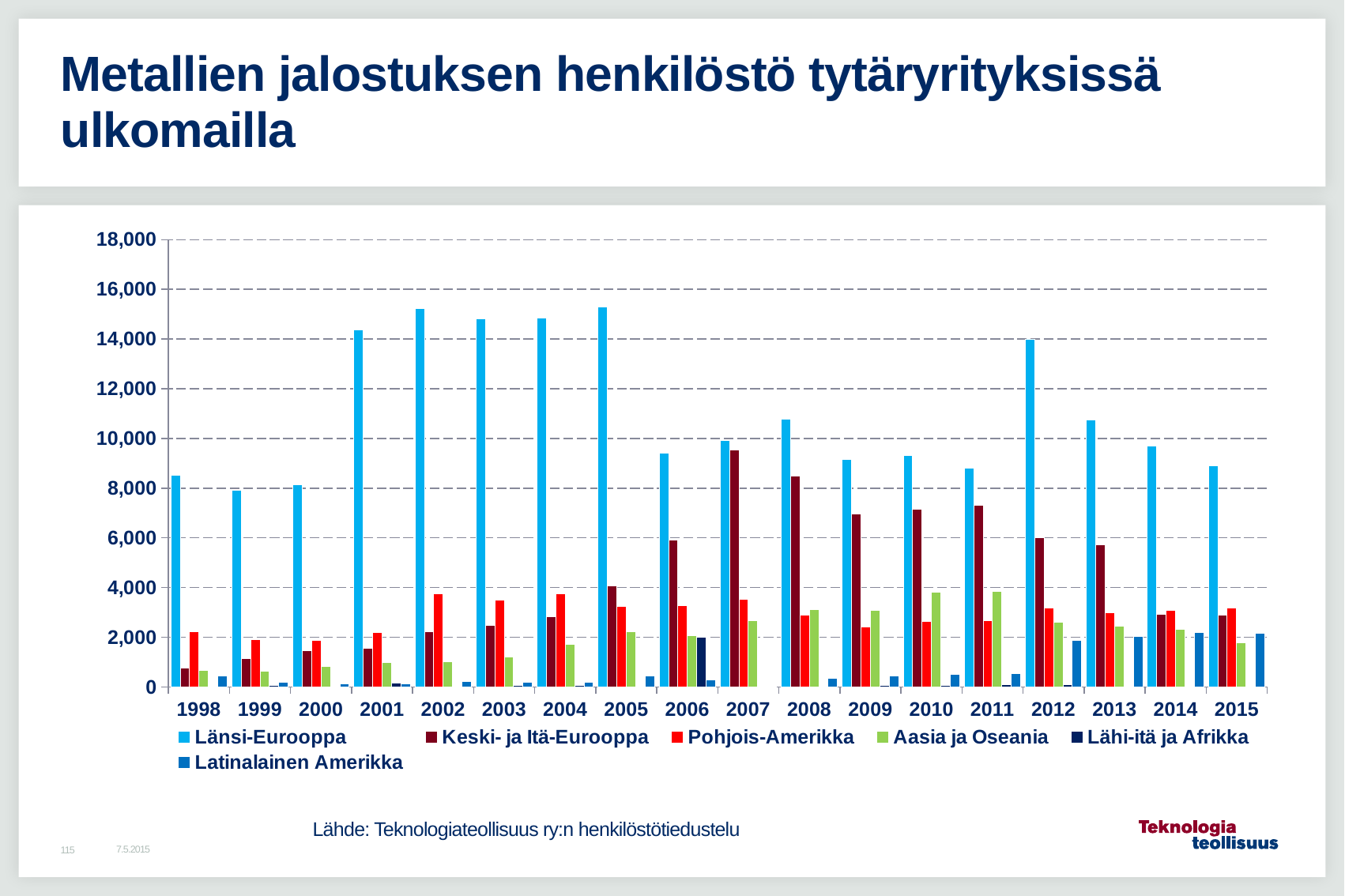
Is the value for Länsi-Eurooppa in 2008 greater or less than 10,000? greater Does the value for Keski- ja Itä-Eurooppa rise or fall from 1998 to 2007? rise In 2008, which is larger: Länsi-Eurooppa or Keski- ja Itä-Eurooppa? Länsi-Eurooppa In 2010, which is larger: Pohjois-Amerikka or Aasia ja Oseania? Aasia ja Oseania Is the value for Aasia ja Oseania in 2011 greater or less than 2,000? greater What source is cited below the chart? Teknologiateollisuus ry:n henkilöstötiedustelu Is the value for Keski- ja Itä-Eurooppa in 2007 greater or less than 8,000? greater How many years are shown on the x axis? 18 In which year is the value for Keski- ja Itä-Eurooppa highest? 2007 How many series does the legend list? 6 What kind of chart is shown on the slide? Bar chart